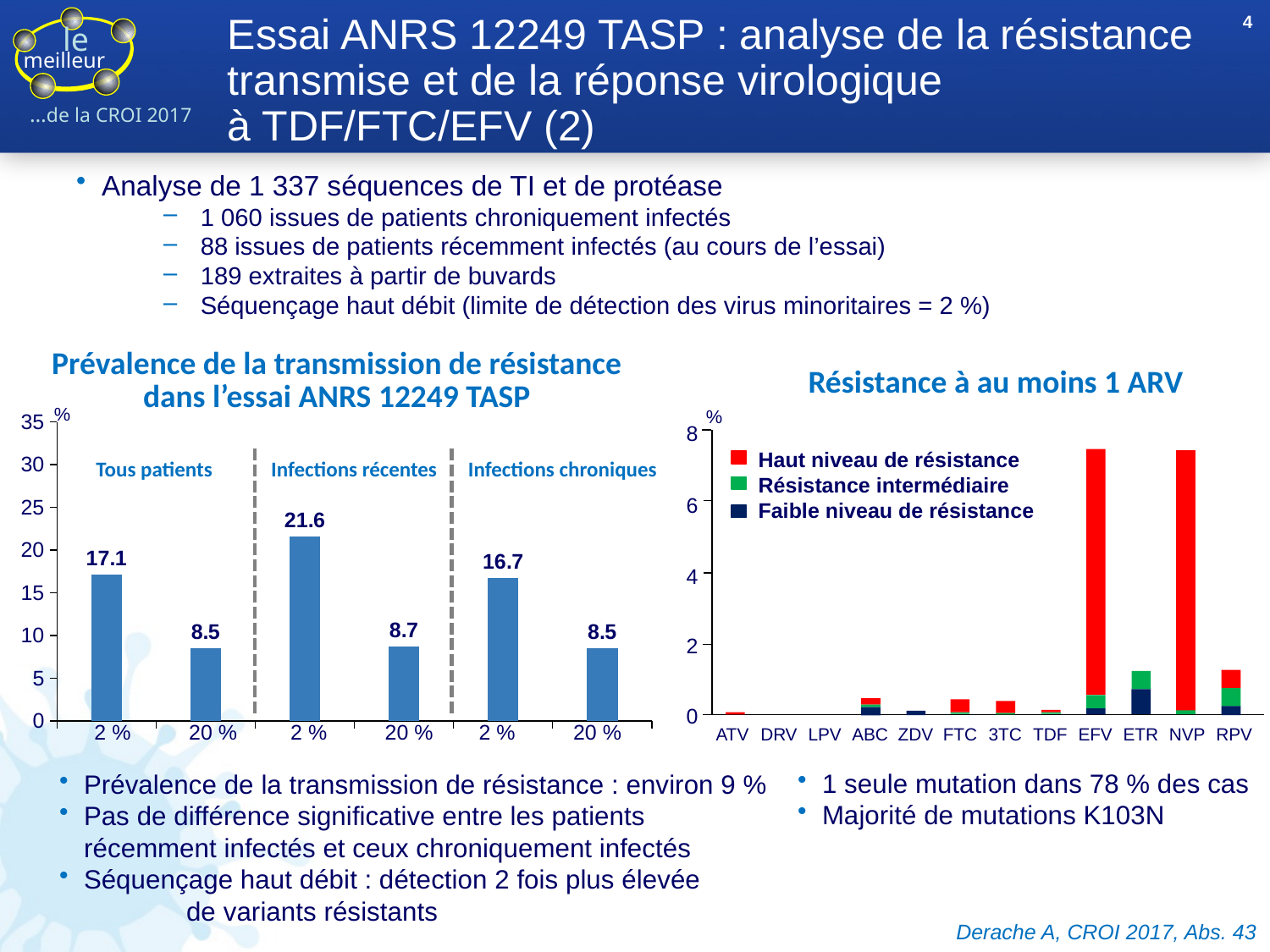
In the chart 'Prévalence de la transmission de résistance dans l'essai ANRS 12249 TASP', what is the value for 'Infections chroniques' at the 20 % threshold? 8.5 In the chart 'Résistance à au moins 1 ARV', which colour represents 'Haut niveau de résistance'? Red How many series does the legend of the chart 'Résistance à au moins 1 ARV' list? 3 In the chart 'Prévalence de la transmission de résistance dans l'essai ANRS 12249 TASP', which is larger: the 2 % value for 'Tous patients' or the 2 % value for 'Infections chroniques'? Tous patients In the chart 'Prévalence de la transmission de résistance dans l'essai ANRS 12249 TASP', which bar has the highest value? Infections récentes, 2 % How many bars are plotted in the chart 'Prévalence de la transmission de résistance dans l'essai ANRS 12249 TASP'? 6 What kind of chart is 'Résistance à au moins 1 ARV'? Stacked bar chart In the chart 'Prévalence de la transmission de résistance dans l'essai ANRS 12249 TASP', what is the difference between the 2 % and 20 % values for 'Infections récentes'? 12.9 In the chart 'Résistance à au moins 1 ARV', is the total value for EFV greater or less than 6? greater In the chart 'Prévalence de la transmission de résistance dans l'essai ANRS 12249 TASP', what is the value for 'Infections récentes' at the 2 % threshold? 21.6 In the chart 'Prévalence de la transmission de résistance dans l'essai ANRS 12249 TASP', what is the value for 'Tous patients' at the 2 % threshold? 17.1 How many ARV categories are shown on the x axis of the chart 'Résistance à au moins 1 ARV'? 12